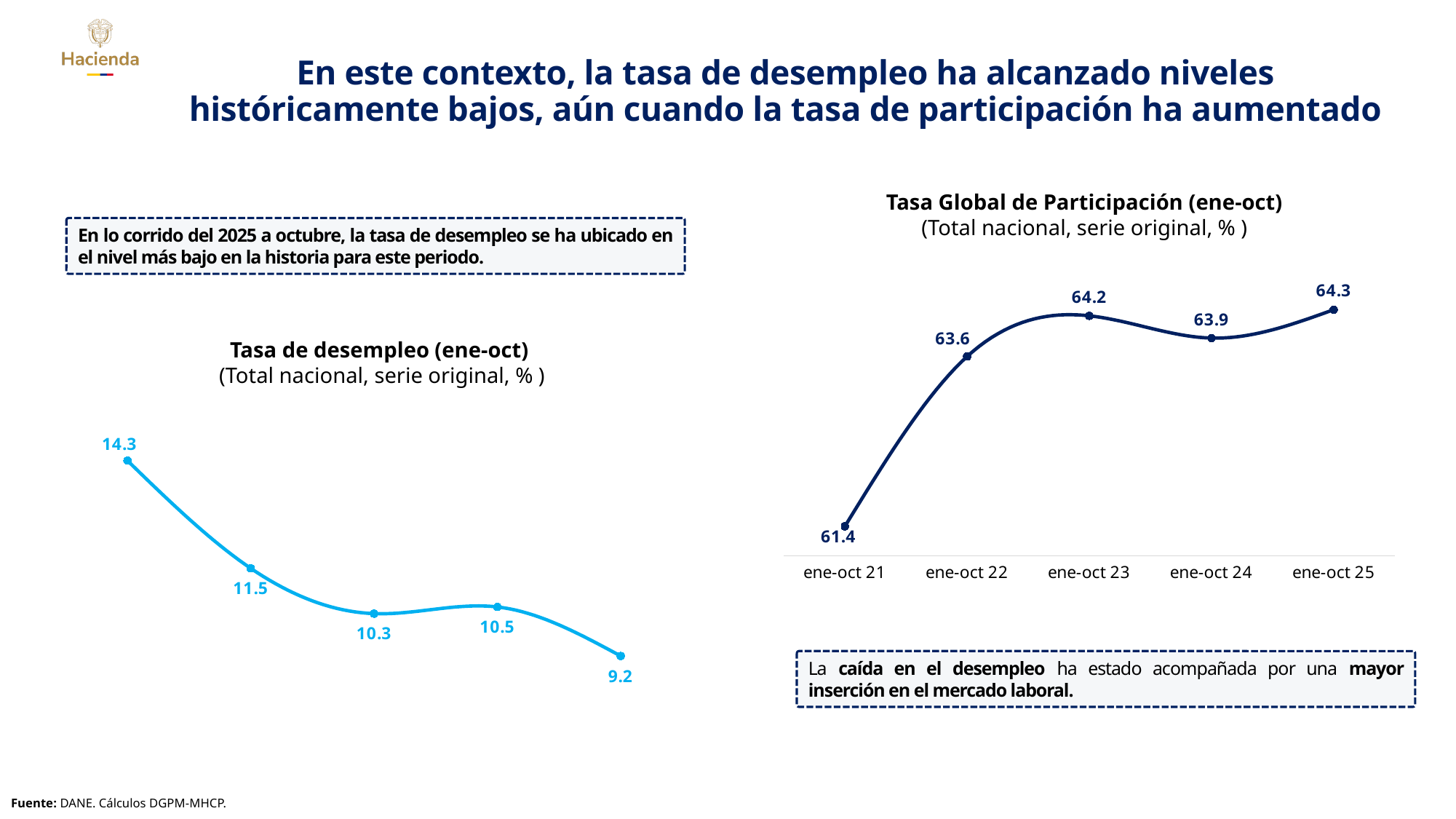
Overall, do the values in the 'Tasa de desempleo (ene-oct)' chart rise or fall from left to right? Fall In the 'Tasa de desempleo (ene-oct)' chart, what is the difference between the first and last values plotted? 5.1 In the 'Tasa Global de Participación (ene-oct)' chart, which is larger, the value for ene-oct 22 or ene-oct 24? ene-oct 24 How many data points are plotted in the 'Tasa Global de Participación (ene-oct)' chart? 5 In the 'Tasa de desempleo (ene-oct)' chart, what is the lowest value shown? 9.2 In the 'Tasa Global de Participación (ene-oct)' chart, what is the value for ene-oct 23? 64.2 In the 'Tasa Global de Participación (ene-oct)' chart, which period has the lowest value? ene-oct 21 In the 'Tasa de desempleo (ene-oct)' chart, what is the highest value shown? 14.3 In the 'Tasa Global de Participación (ene-oct)' chart, what is the value for ene-oct 21? 61.4 In the 'Tasa Global de Participación (ene-oct)' chart, what is the difference between the values for ene-oct 25 and ene-oct 21? 2.9 In the 'Tasa Global de Participación (ene-oct)' chart, which period has the highest value? ene-oct 25 What kind of chart is the 'Tasa de desempleo (ene-oct)' chart? Line chart